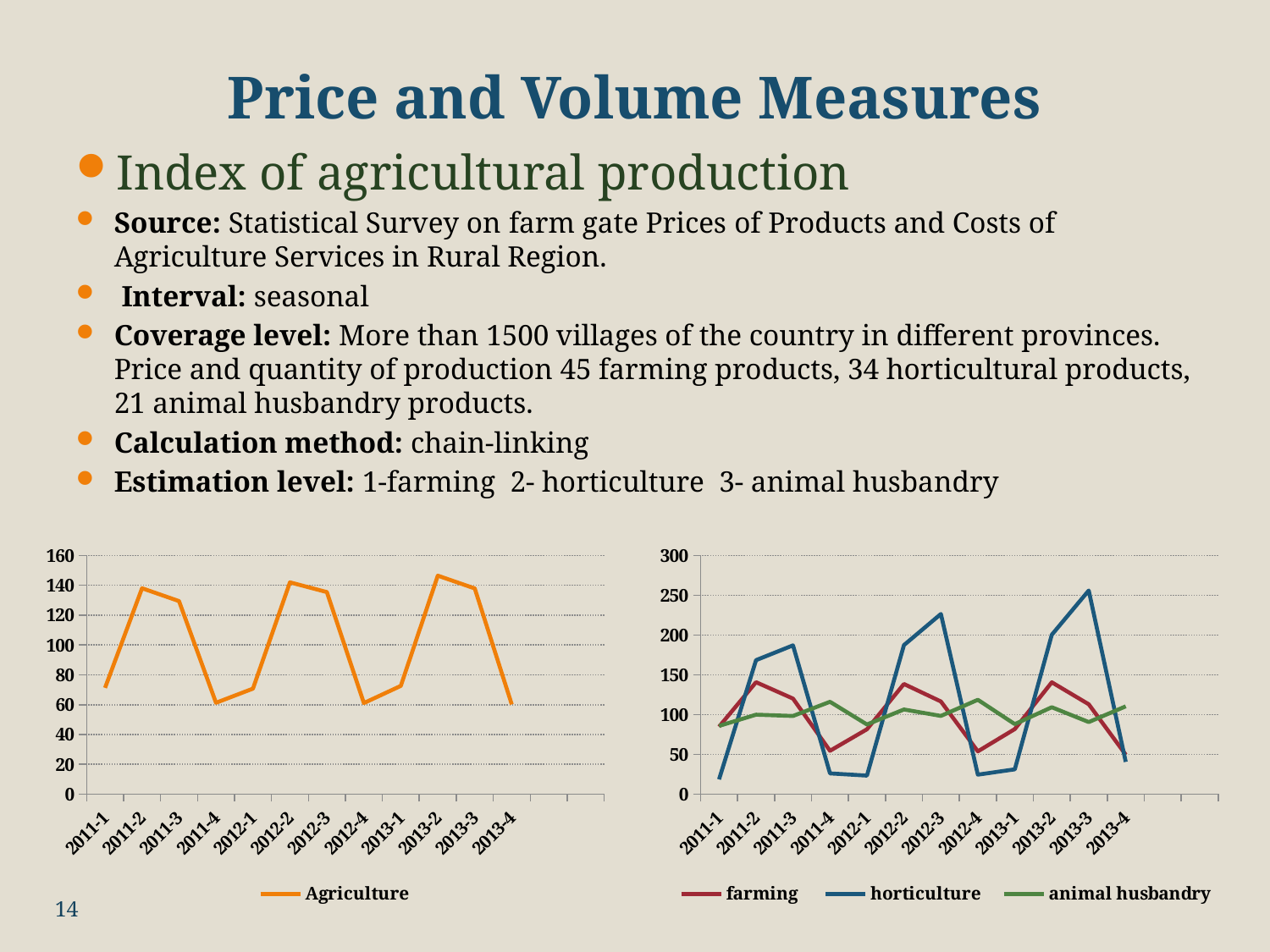
How many series does the legend of the right chart list? 3 What are the three series named in the legend of the right chart? farming, horticulture, animal husbandry How many periods are labelled on the x axis of the left Agriculture chart? 12 What kind of chart is the left chart with the Agriculture series? line chart In the left Agriculture chart, is the value for 2011-2 greater or less than 120? greater In the right chart, is the horticulture value for 2013-3 greater or less than 200? greater In the right chart, which is larger at 2012-3: farming or horticulture? horticulture In the right chart, is the horticulture value for 2011-4 greater or less than 50? less In the left Agriculture chart, does the value rise or fall from 2011-1 to 2011-2? rise In the right chart, which series has the highest value at 2013-3? horticulture In the right chart, in which period does horticulture reach its highest value? 2013-3